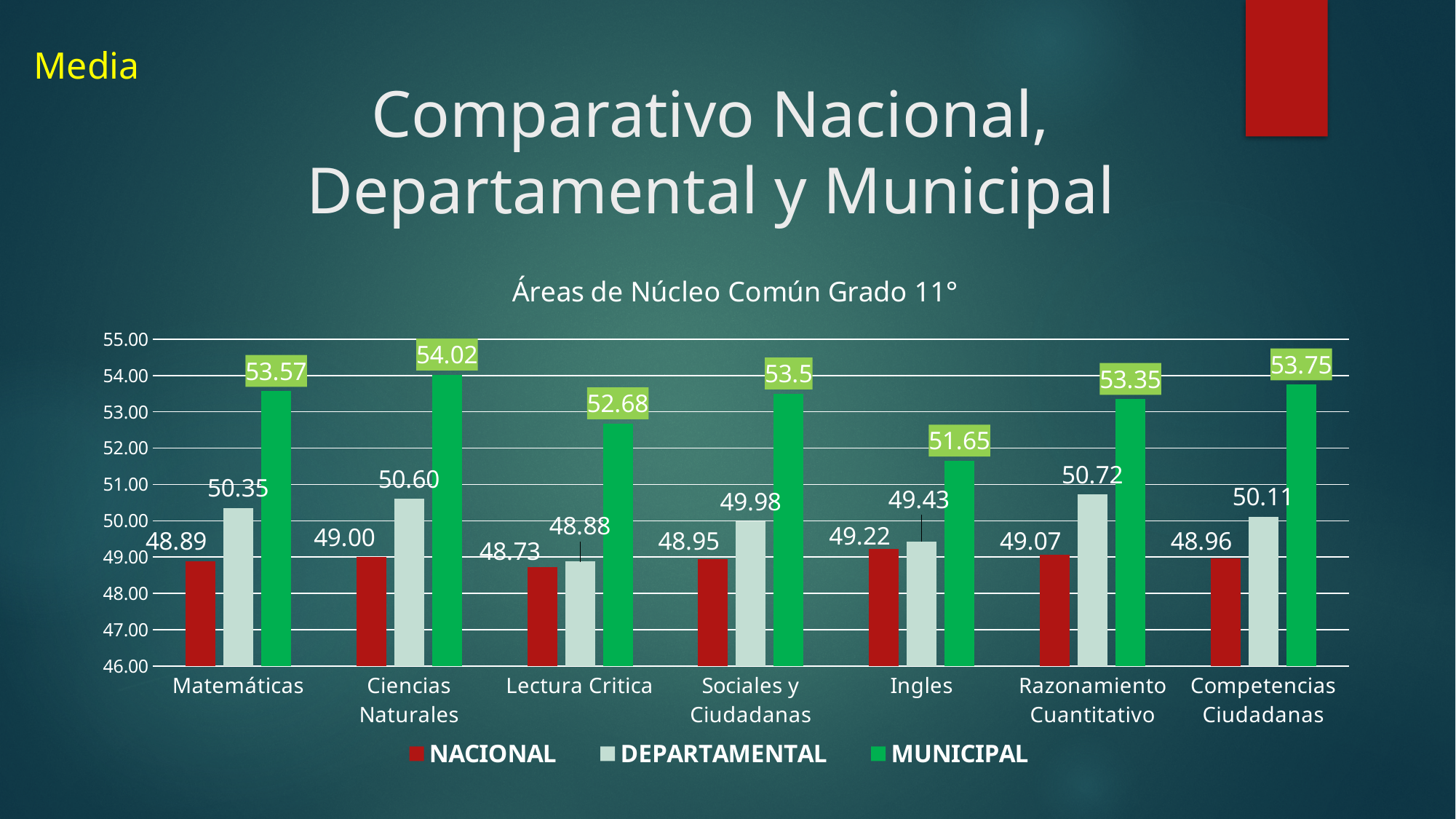
What is the DEPARTAMENTAL value for Razonamiento Cuantitativo? 50.72 What is the difference between the MUNICIPAL and NACIONAL values for Matemáticas? 4.68 Which category has the lowest MUNICIPAL value? Ingles How many categories are shown on the x axis? 7 Which is larger: the DEPARTAMENTAL value for Ciencias Naturales or the DEPARTAMENTAL value for Competencias Ciudadanas? Ciencias Naturales What is the MUNICIPAL value for Ciencias Naturales? 54.02 What type of chart is shown on the slide? bar chart Is the MUNICIPAL value for Lectura Critica greater or less than 53.00? less How many series does the legend list? 3 Which category has the highest MUNICIPAL value? Ciencias Naturales What is the NACIONAL value for Ingles? 49.22 Which category has the lowest NACIONAL value? Lectura Critica